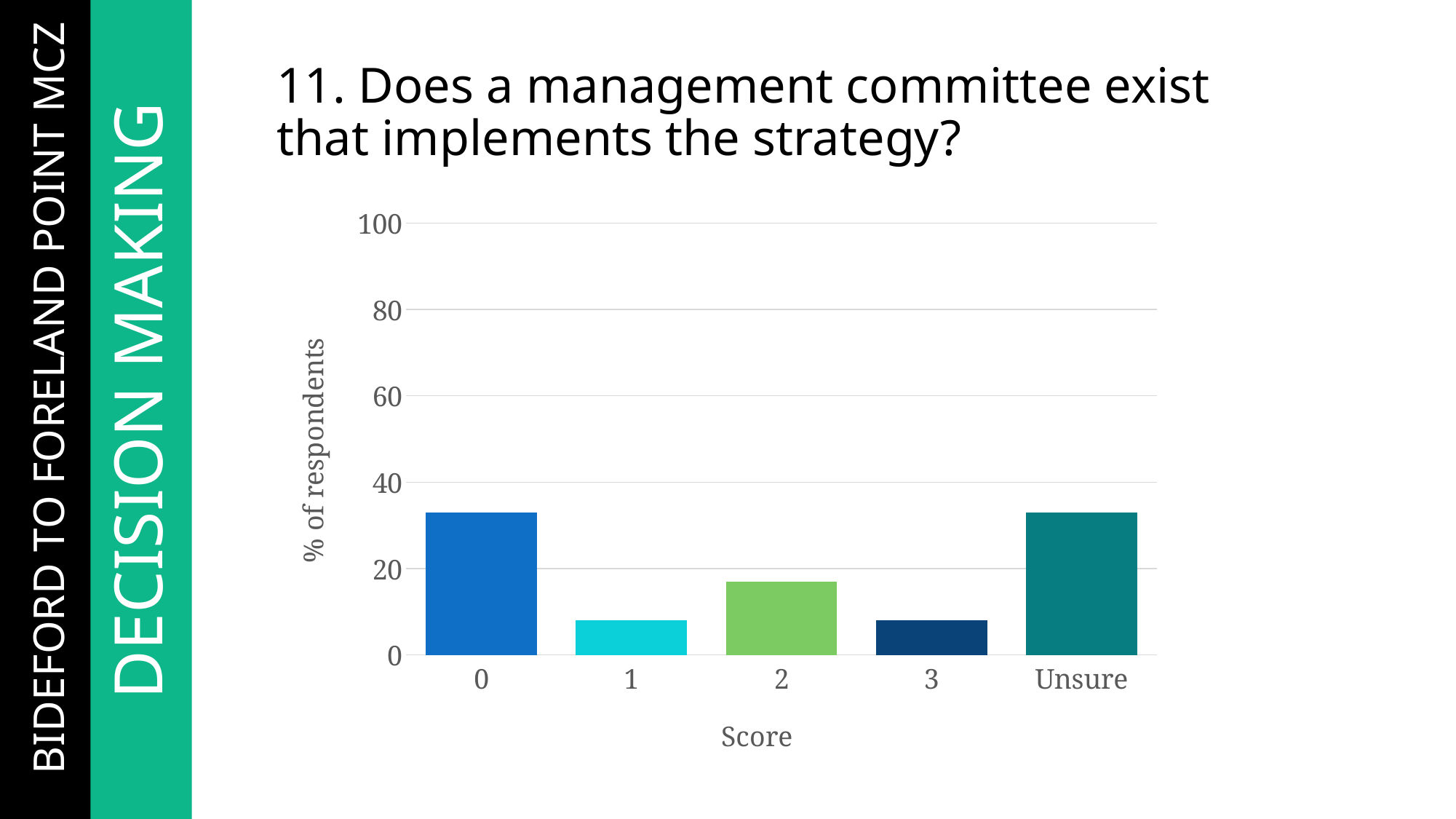
Is the value for Unsure greater or less than 20? greater Which has a higher percentage of respondents, score 0 or score 1? 0 Which has a higher percentage of respondents, Unsure or score 2? Unsure Is the value for score 0 greater or less than 20? greater What is the label on the vertical axis of the chart? % of respondents What is the label on the horizontal axis of the chart? Score Is the value for score 3 greater or less than 20? less What kind of chart is shown on the slide? bar chart How many score categories are shown on the x axis of the chart? 5 Which has a higher percentage of respondents, score 2 or score 3? 2